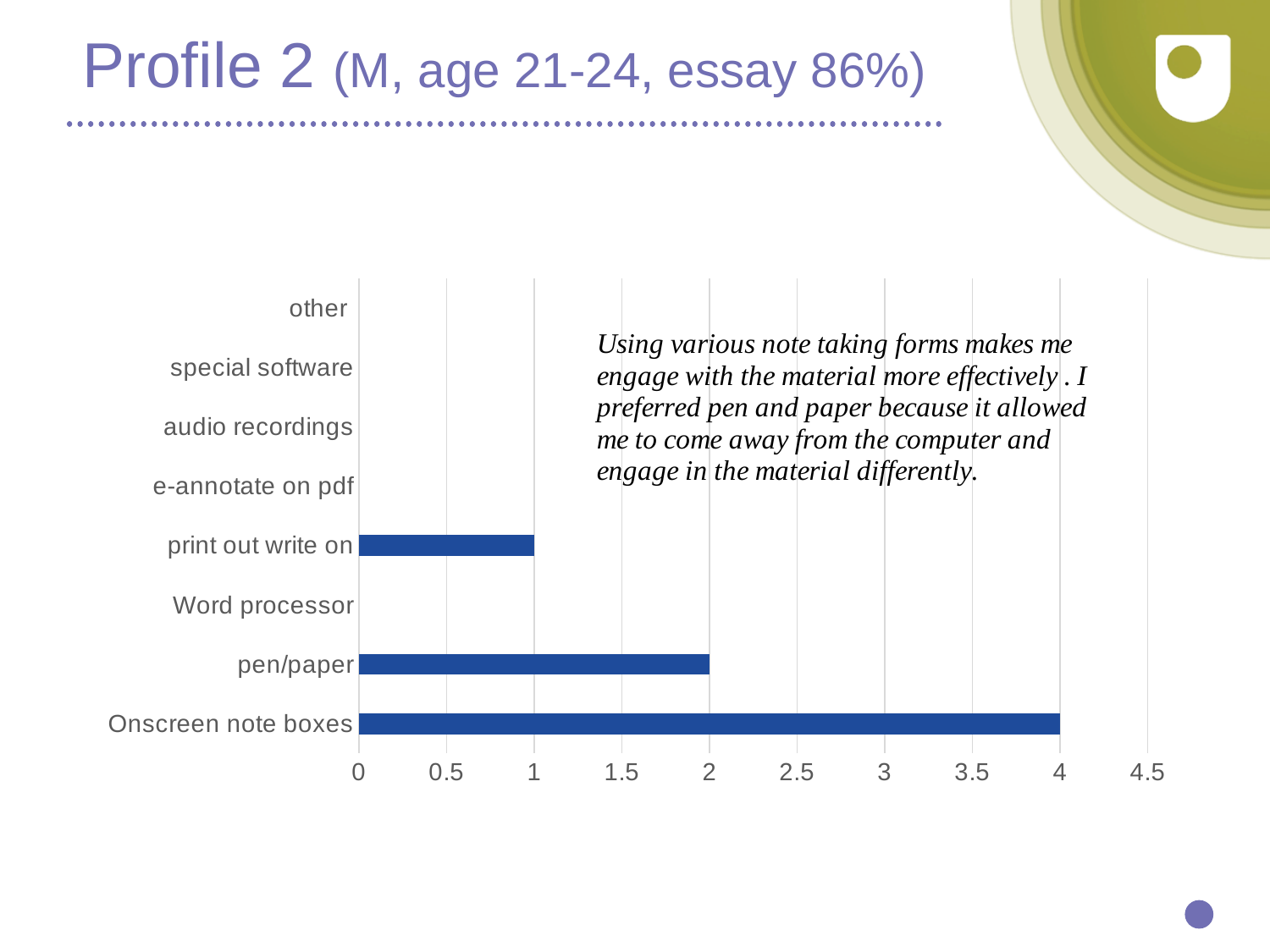
How many categories are listed on the vertical axis of the chart? 8 What is the difference between the values for Onscreen note boxes and pen/paper? 2 Is the value for print out write on greater or less than 1.5? less Which is larger, the value for pen/paper or the value for print out write on? pen/paper Is the value for Onscreen note boxes greater or less than 3? greater What is the value for print out write on? 1 What colour are the bars in the chart? blue What is the value for pen/paper? 2 Which category has the highest value in the chart? Onscreen note boxes What kind of chart is shown on the slide? bar chart What is the highest value shown on the horizontal axis of the chart? 4.5 What is the value for Onscreen note boxes? 4